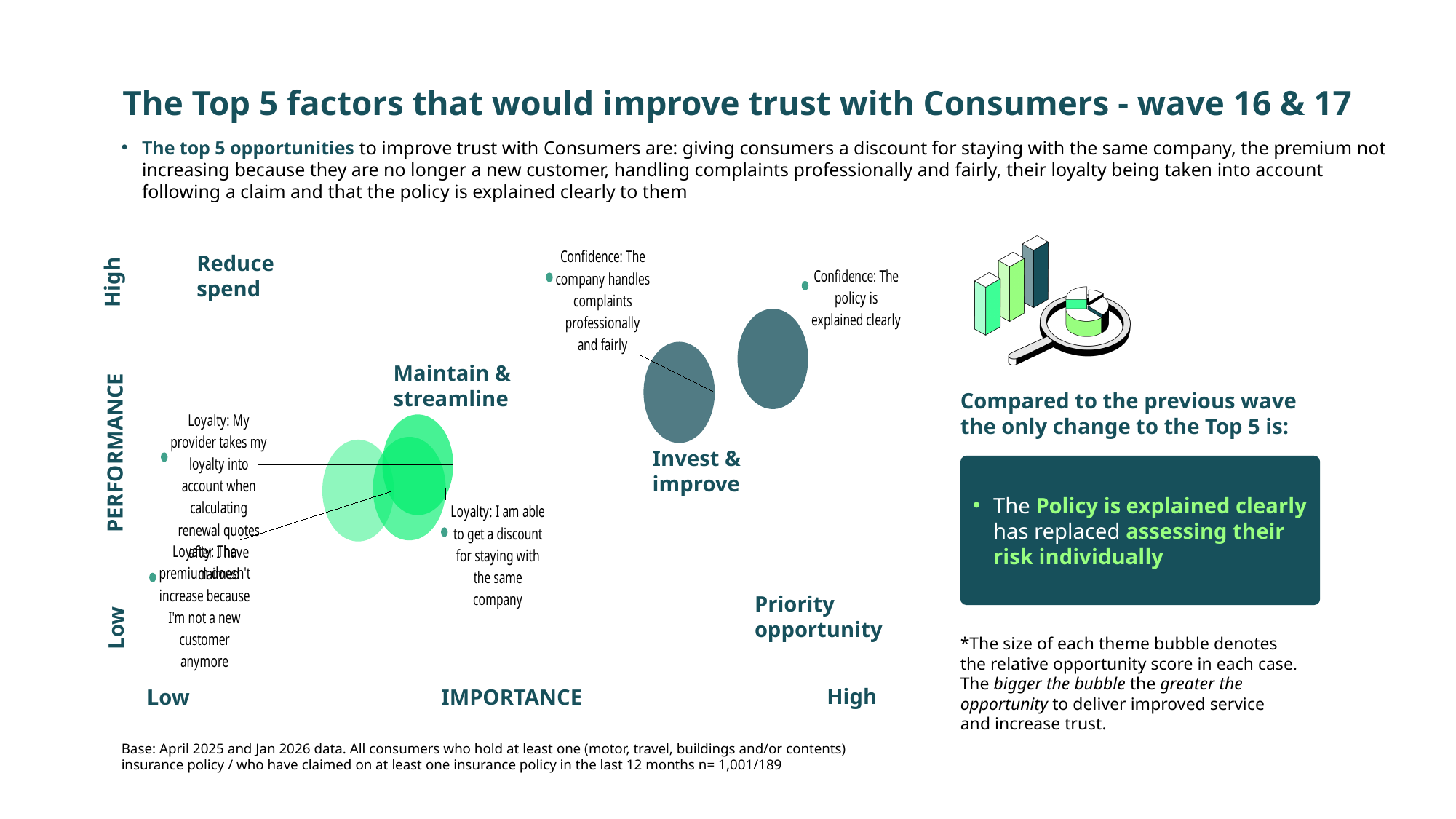
Is the bubble for 'Confidence: The company handles complaints professionally and fairly' higher or lower on the performance axis than the bubble for 'Loyalty: I am able to get a discount for staying with the same company'? Higher How many bubbles are plotted on the chart? 5 What is the label of the horizontal axis of the chart? IMPORTANCE What kind of chart is shown on the slide? Bubble chart Which quadrant label appears in the bottom-right area of the chart? Priority opportunity According to the slide, what does the size of each bubble denote? The relative opportunity score Which factor's bubble is positioned highest on the performance axis? Confidence: The policy is explained clearly Which factor's bubble is positioned furthest to the right (highest importance) on the chart? Confidence: The policy is explained clearly